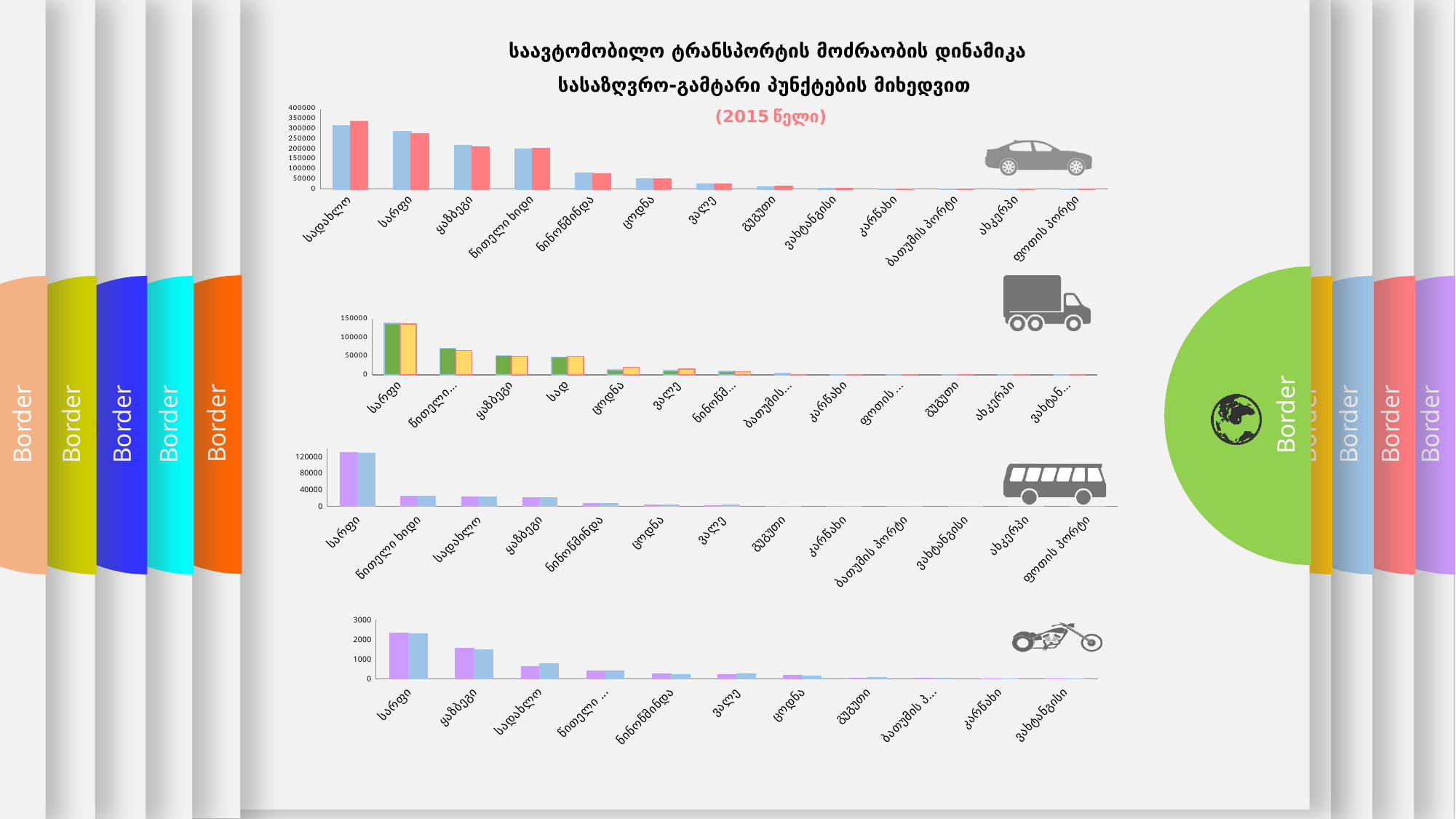
Which year is shown in the title above the charts? 2015 How many categories are shown on the x axis of the bottom chart (motorcycle icon)? 11 In the third chart from the top (bus icon), do the values rise or fall moving left to right along the x axis? fall What kind of chart is the top chart on the slide (the one with the car icon)? bar chart In the top chart (car icon), is the value for ნინოწმინდა greater or less than 100000? less In the second chart from the top (truck icon), is the value for სარფი greater or less than 100000? greater In the top chart (car icon), which category has the highest values? სადახლო How many categories are shown on the x axis of the top chart (car icon)? 13 In the top chart (car icon), is the value for სარფი greater or less than 250000? greater In the second chart from the top (truck icon), which category has the highest values? სარფი